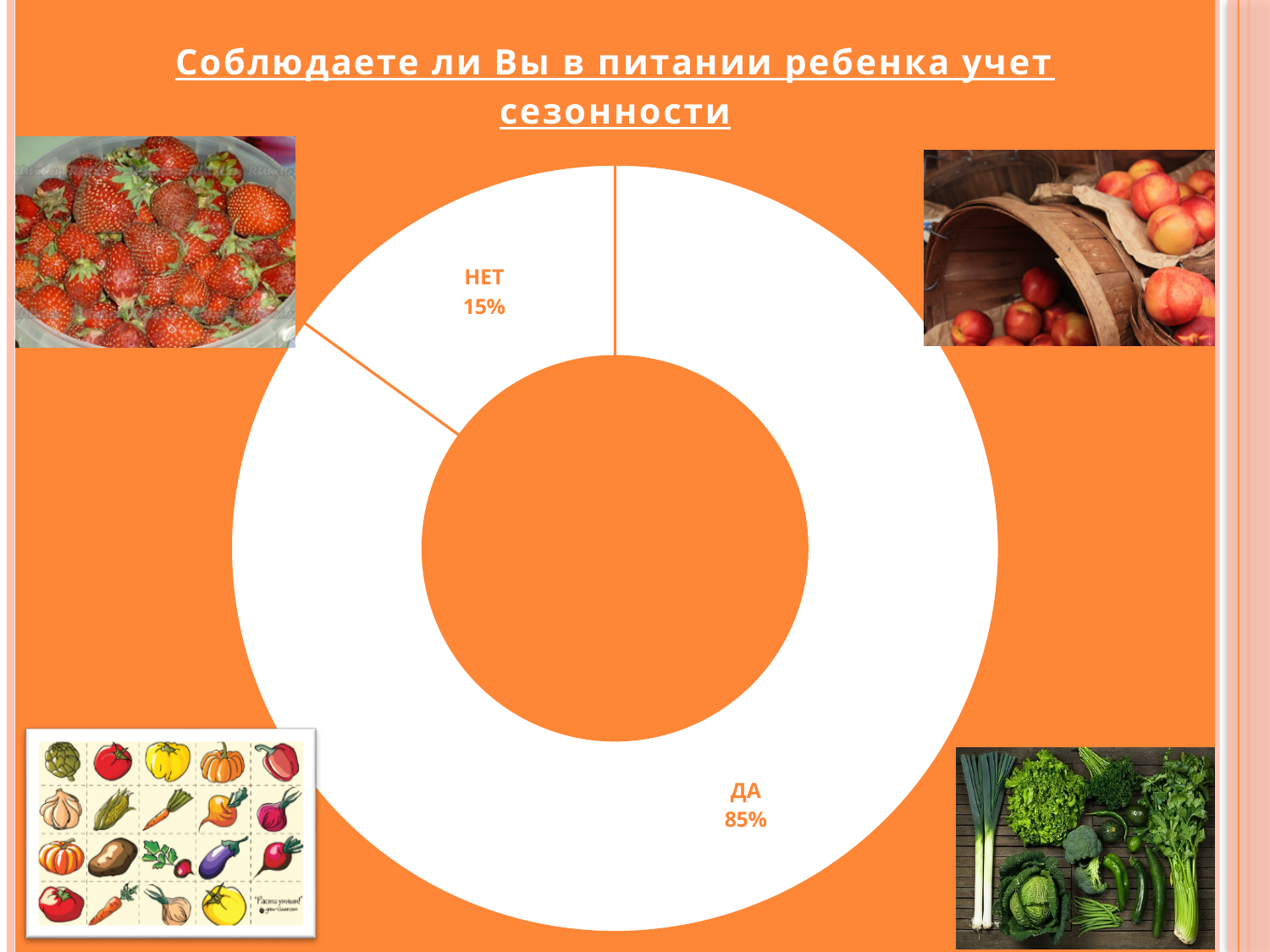
How many categories are shown in the chart? 2 What percentage of respondents answered ДА? 85% Which answer has the smallest share of the chart? НЕТ Which answer has the largest share of the chart? ДА What is the title of the slide? Соблюдаете ли Вы в питании ребенка учет сезонности Which is larger, the share for ДА or the share for НЕТ? ДА What colour are the slices of the chart? White What is the difference in percentage points between the ДА and НЕТ shares? 70 What kind of chart is shown on the slide? Doughnut chart What percentage of respondents answered НЕТ? 15% What share of the chart does the НЕТ slice represent? 15%